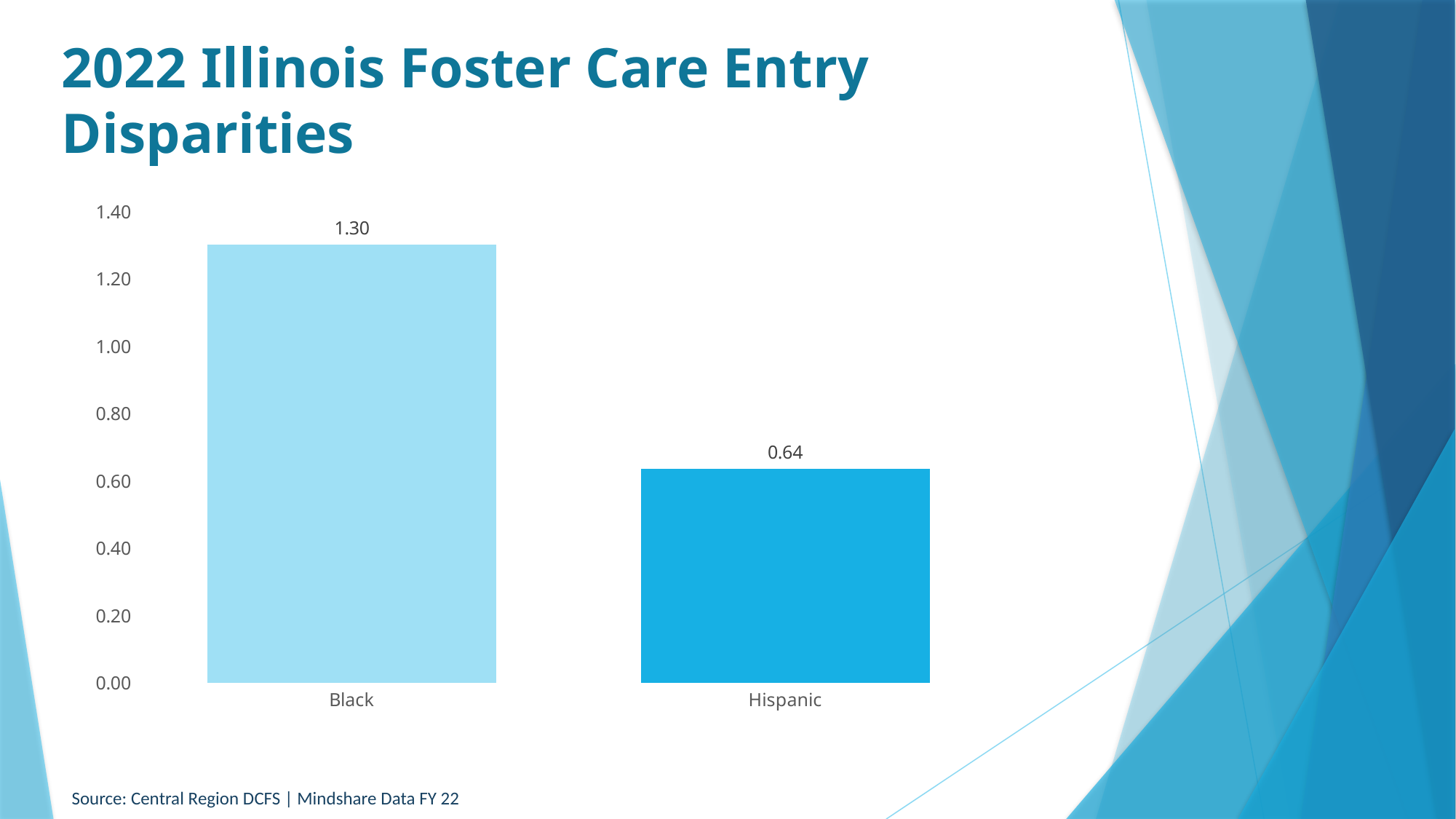
Which is larger, the value for Black or the value for Hispanic? Black Is the value for Black greater or less than 1.00? greater What is the title of the slide? 2022 Illinois Foster Care Entry Disparities What is the value for Black? 1.30 What is the difference between the values for Black and Hispanic? 0.66 What kind of chart is shown on the slide? bar chart Is the value for Hispanic greater or less than 0.80? less What is the highest value shown on the vertical axis? 1.40 What is the value for Hispanic? 0.64 Which category has the lowest value? Hispanic Which category has the highest value? Black How many categories are shown in the chart? 2